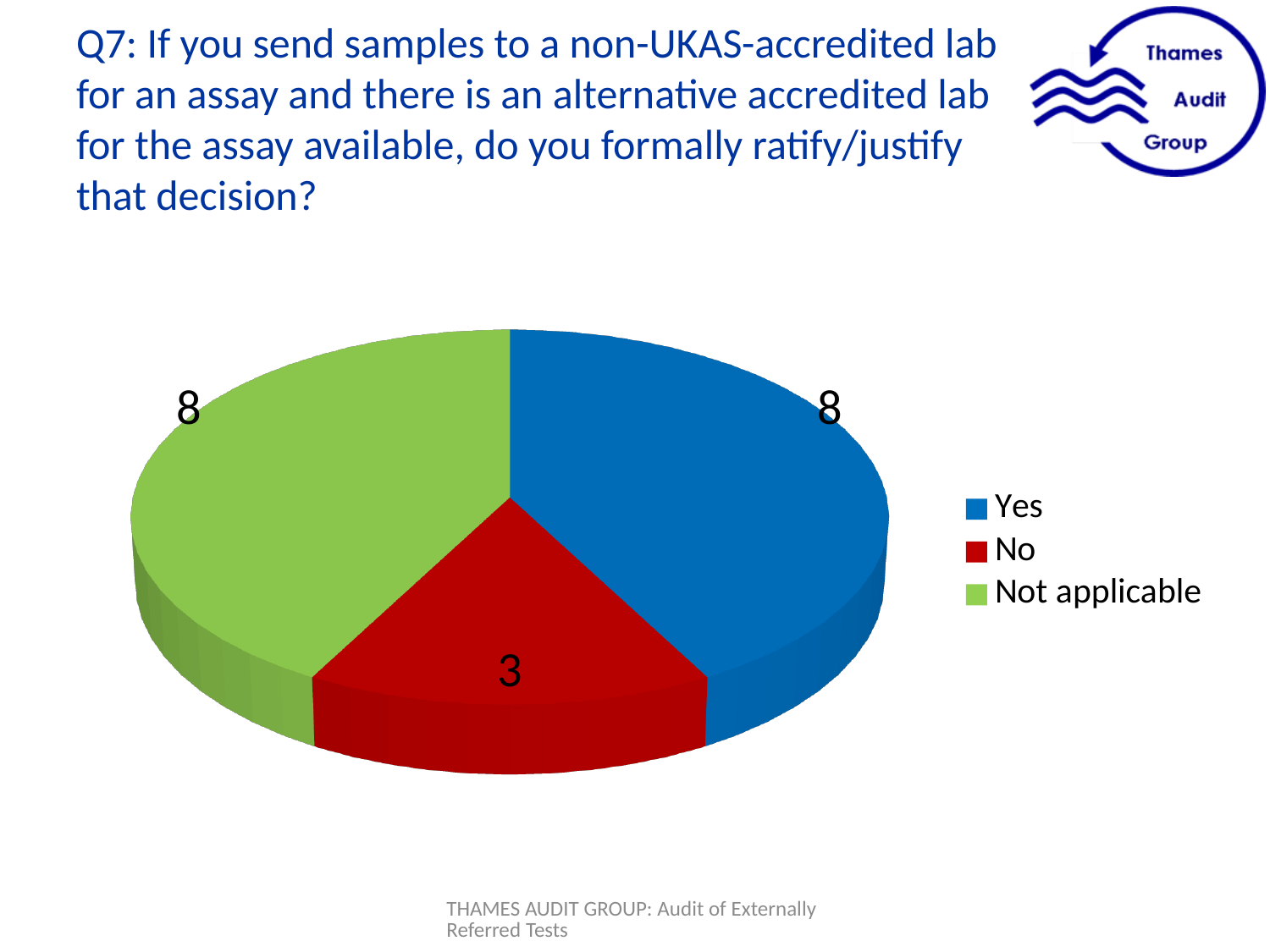
What value is shown for the Yes slice of the pie chart? 8 What colour represents the Not applicable category in the pie chart? Green How many entries does the legend of the pie chart list? 3 What kind of chart is shown on the slide? Pie chart How many slices does the pie chart have? 3 Which is larger in the pie chart, Yes or No? Yes What value is shown for the No slice of the pie chart? 3 What is the difference between the Yes value and the No value in the pie chart? 5 Which category has the smallest slice in the pie chart? No What is the total of all the slices in the pie chart? 19 What value is shown for the Not applicable slice of the pie chart? 8 What colour represents the No category in the pie chart? Red